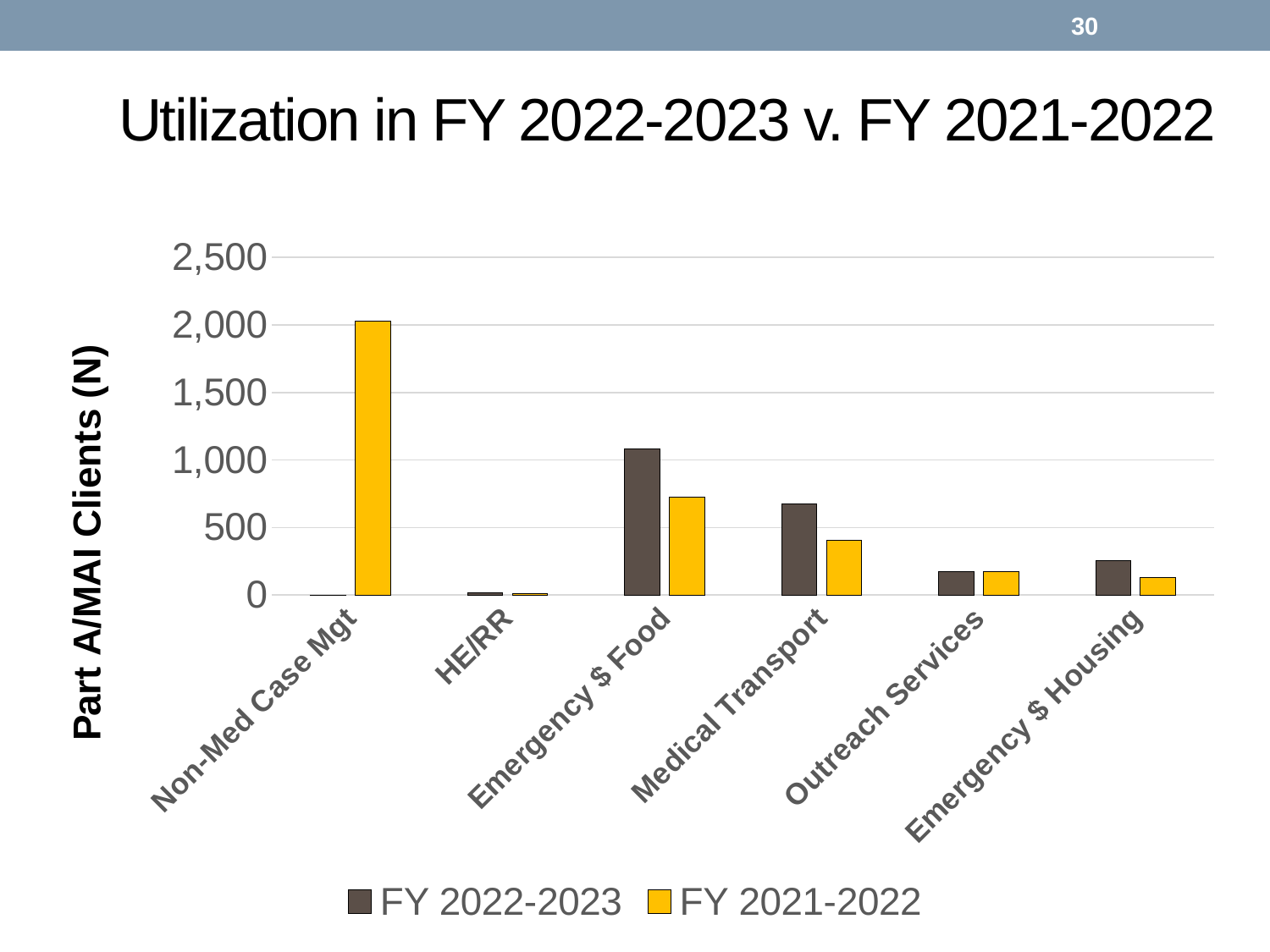
Is the FY 2022-2023 value for Medical Transport greater or less than 500? greater What is the title of the vertical axis? Part A/MAI Clients (N) Is the FY 2021-2022 value for Medical Transport greater or less than 500? less Is the FY 2021-2022 value for Non-Med Case Mgt greater or less than 1,500? greater What kind of chart is shown on the slide? Bar chart Which category has the highest value for FY 2022-2023? Emergency $ Food For Emergency $ Food, which series has the larger value, FY 2022-2023 or FY 2021-2022? FY 2022-2023 For Emergency $ Housing, which series has the larger value, FY 2022-2023 or FY 2021-2022? FY 2022-2023 How many series does the legend list? 2 How many service categories are shown on the x axis? 6 Which category has the highest value for FY 2021-2022? Non-Med Case Mgt